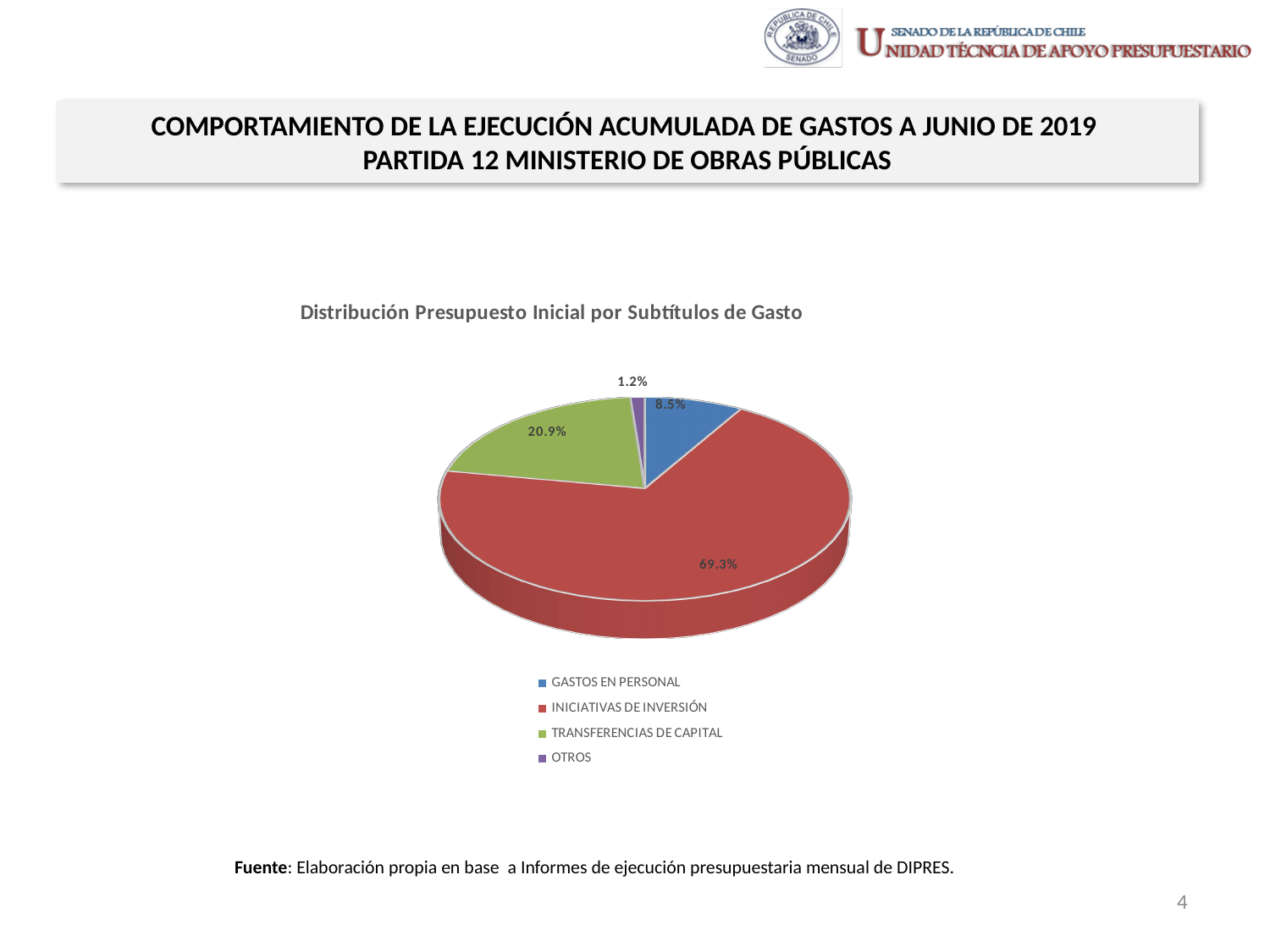
What share of the pie does GASTOS EN PERSONAL represent? 8.5% What share of the pie does TRANSFERENCIAS DE CAPITAL represent? 20.9% Which category has the largest share of the pie? INICIATIVAS DE INVERSIÓN What share of the pie does INICIATIVAS DE INVERSIÓN represent? 69.3% How many categories does the pie chart show? 4 Which category has the smallest share of the pie? OTROS What colour is the slice for INICIATIVAS DE INVERSIÓN? Red What is the difference in percentage points between the shares of INICIATIVAS DE INVERSIÓN and TRANSFERENCIAS DE CAPITAL? 48.4 percentage points What is the title of the chart? Distribución Presupuesto Inicial por Subtítulos de Gasto What type of chart is shown on the slide? Pie chart Which is larger, the share for TRANSFERENCIAS DE CAPITAL or the share for GASTOS EN PERSONAL? TRANSFERENCIAS DE CAPITAL